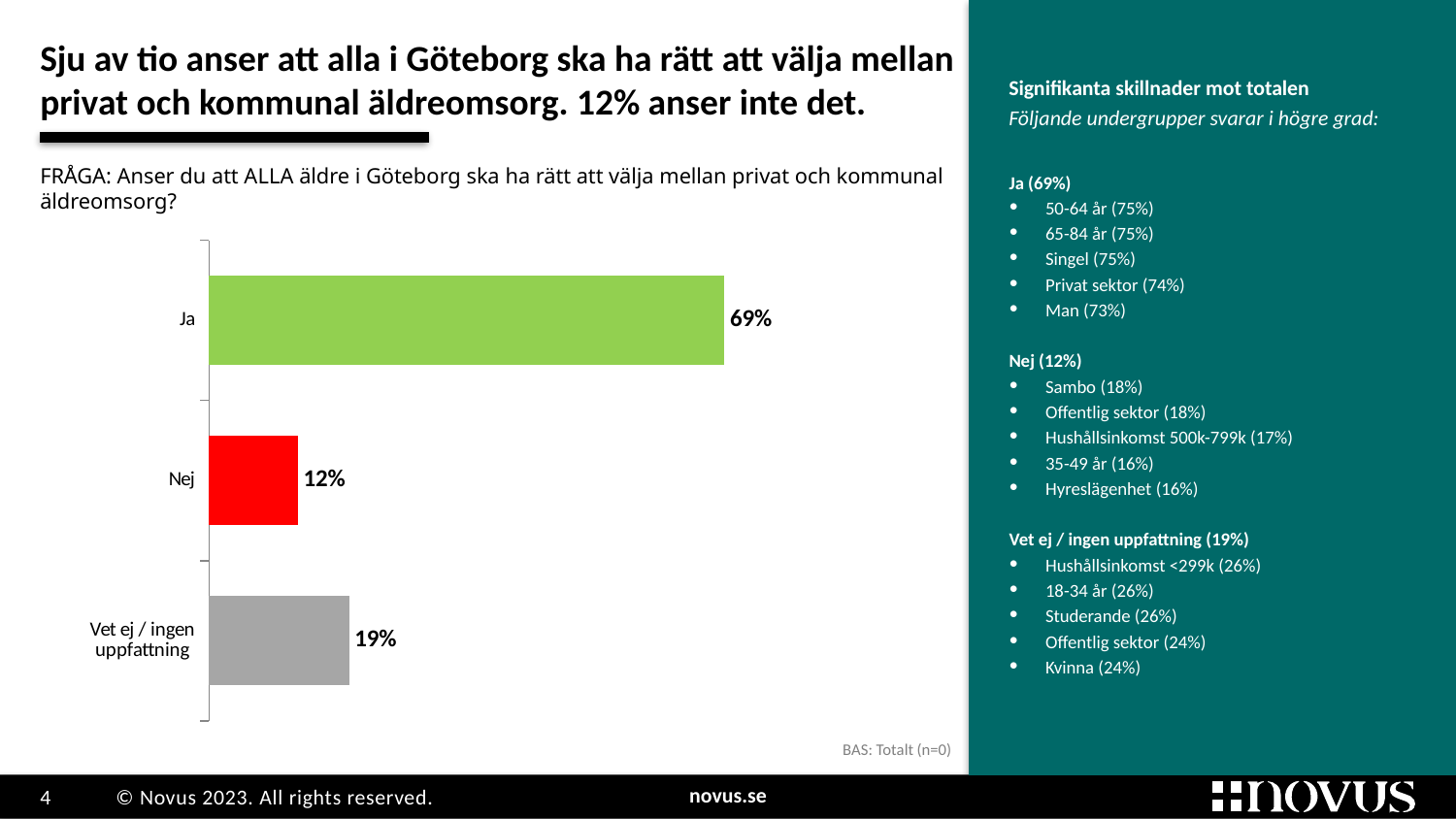
What is the value for "Ja"? 69% Which category has the highest value? Ja What is the value for "Vet ej / ingen uppfattning"? 19% What is the value for "Nej"? 12% What colour is the bar for "Ja"? Green Which is larger, the value for "Nej" or the value for "Vet ej / ingen uppfattning"? Vet ej / ingen uppfattning What kind of chart is shown on the slide? Bar chart Which category has the lowest value? Nej What colour is the bar for "Nej"? Red What is the difference between the values for "Ja" and "Nej"? 57% How many categories are shown in the chart? 3 What is the difference between the values for "Vet ej / ingen uppfattning" and "Nej"? 7%